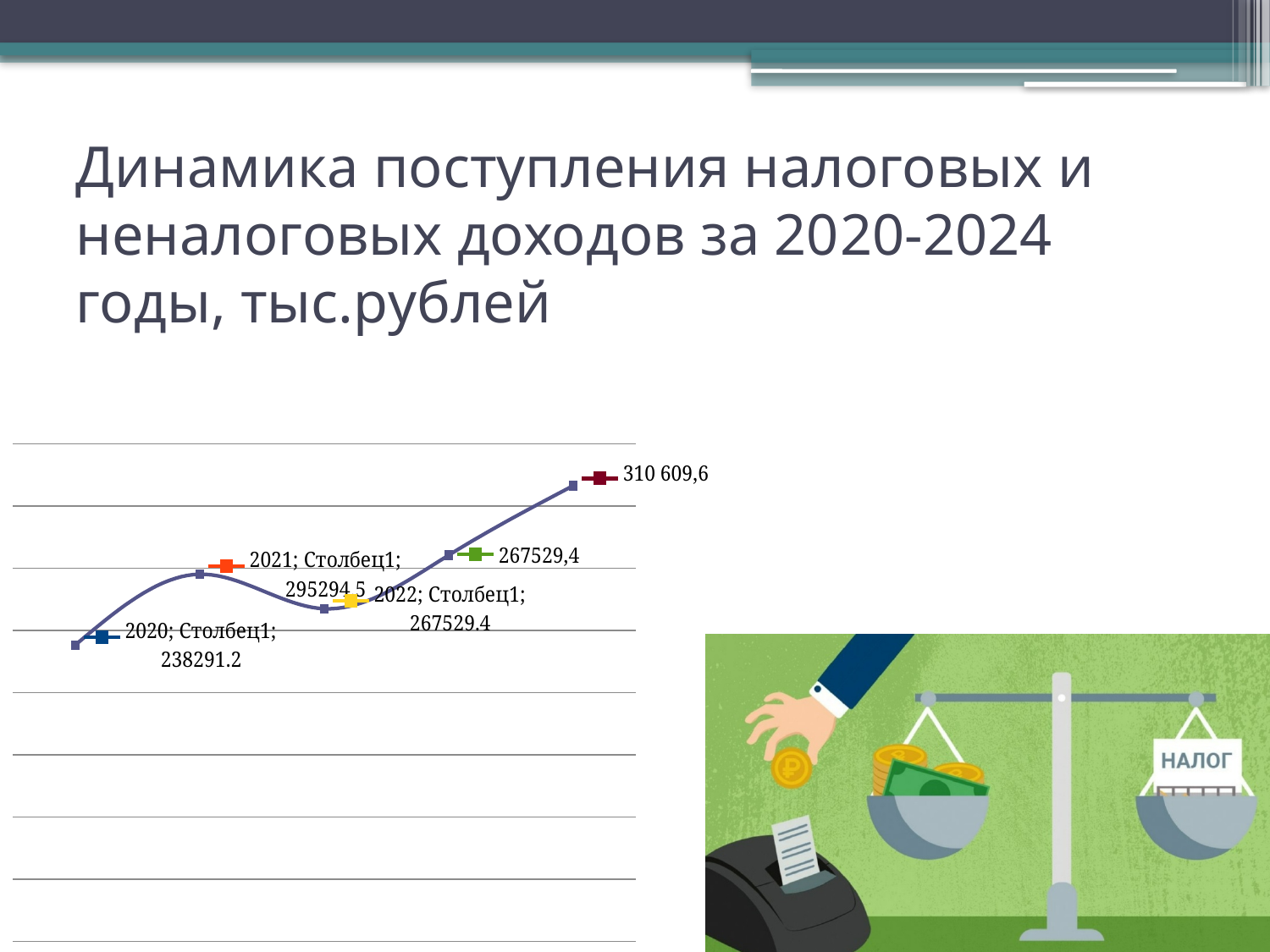
How many data points are plotted on the chart? 5 What is the value for 2021 on the chart? 295294.5 What is the value for 2022 on the chart? 267529.4 What is the difference between the values for 2021 and 2020? 57003.3 What is the highest value labelled on the chart? 310 609,6 What kind of chart is shown on the slide? line chart What is the difference between the values for 2021 and 2022? 27765.1 Is the last point on the chart higher or lower than the first point? higher Which is larger, the value for 2020 or the value for 2022? 2022 What is the value for 2020 on the chart? 238291.2 Which year has the lowest value on the chart? 2020 What series name appears in the data labels of the chart? Столбец1